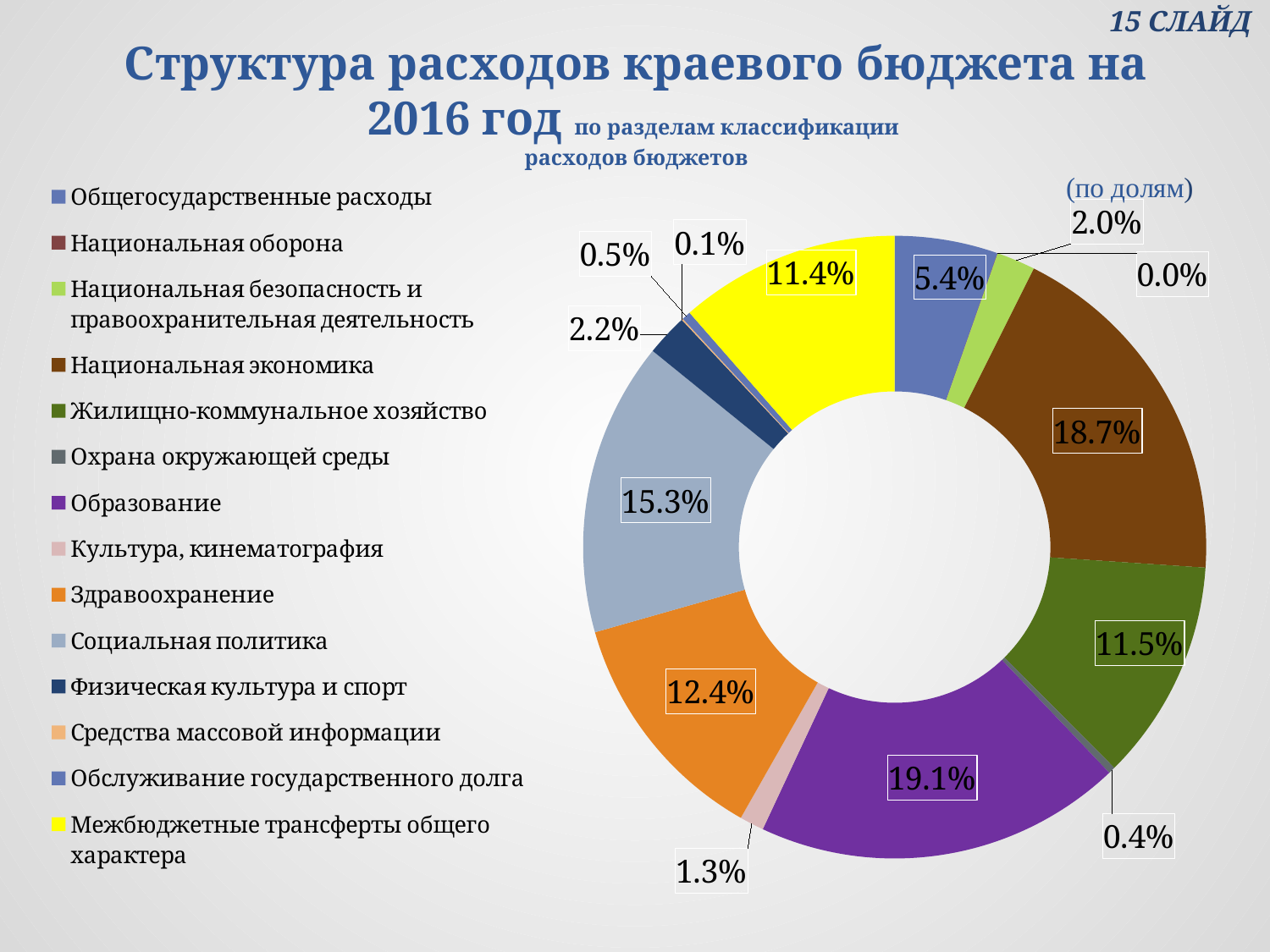
What is the difference in share between Образование and Национальная экономика? 0.4% What share of expenditures goes to Общегосударственные расходы? 5.4% What share of expenditures goes to Межбюджетные трансферты общего характера? 11.4% What kind of chart is shown on the slide? Doughnut (pie) chart What share of expenditures goes to Социальная политика? 15.3% What share of expenditures goes to Жилищно-коммунальное хозяйство? 11.5% What share of expenditures goes to Образование? 19.1% Which section has the largest share of the 2016 regional budget expenditures? Образование How many expenditure sections are listed in the legend? 14 Which has a larger share: Социальная политика or Здравоохранение? Социальная политика What share of expenditures goes to Здравоохранение? 12.4% What share of expenditures goes to Национальная экономика? 18.7%